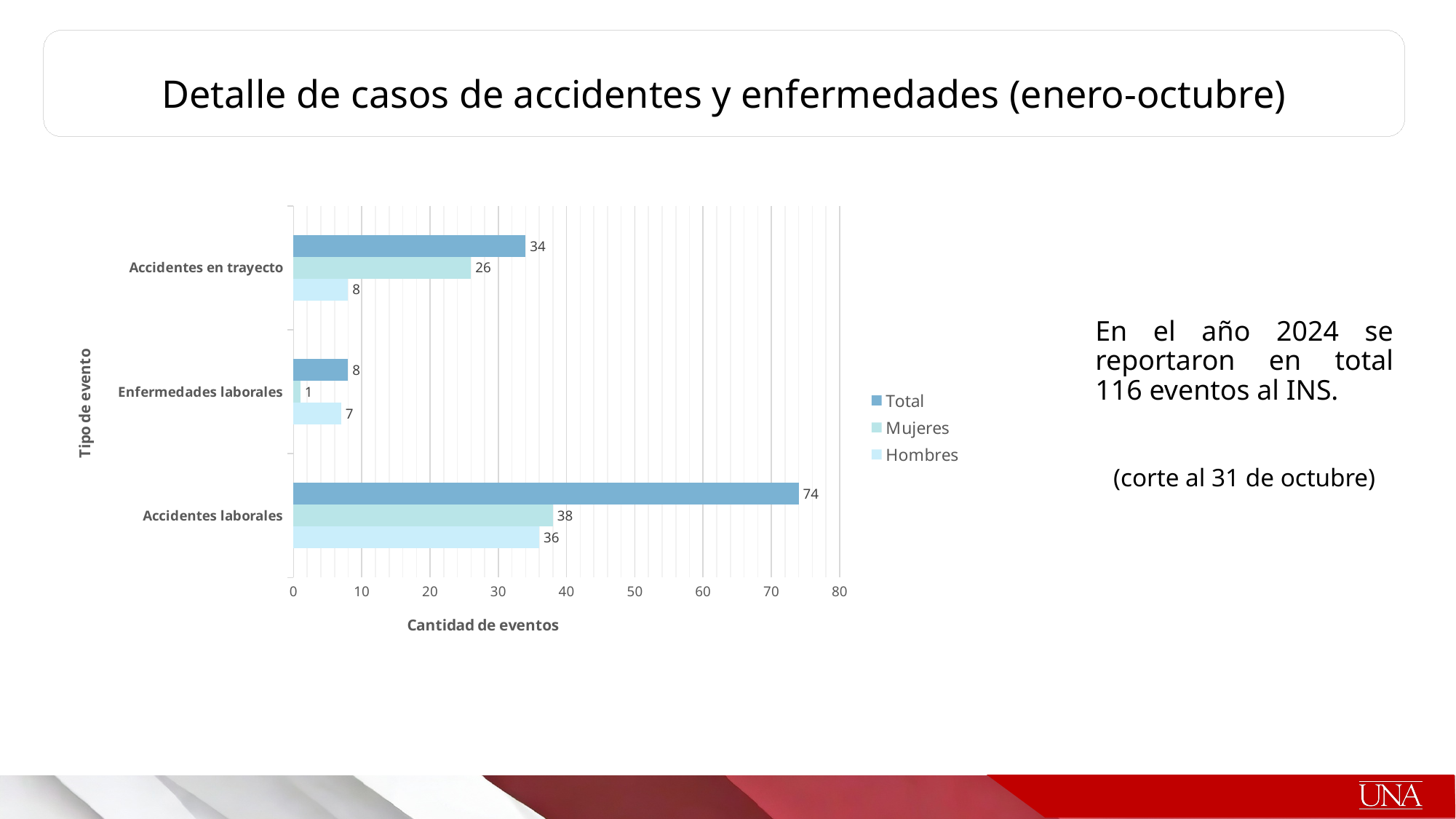
Which category has the highest Total value? Accidentes laborales What is the label of the x axis? Cantidad de eventos What is the Hombres value for Enfermedades laborales? 7 Which category has the lowest Mujeres value? Enfermedades laborales What is the Total value for Accidentes laborales? 74 How many series does the legend list? 3 Is the Total value for Accidentes en trayecto greater or less than 30? greater Which is larger for Accidentes laborales, the Mujeres value or the Hombres value? Mujeres How many categories are shown on the y axis? 3 What kind of chart is shown on the slide? bar chart What is the Mujeres value for Accidentes en trayecto? 26 What is the difference between the Mujeres and Hombres values for Accidentes en trayecto? 18